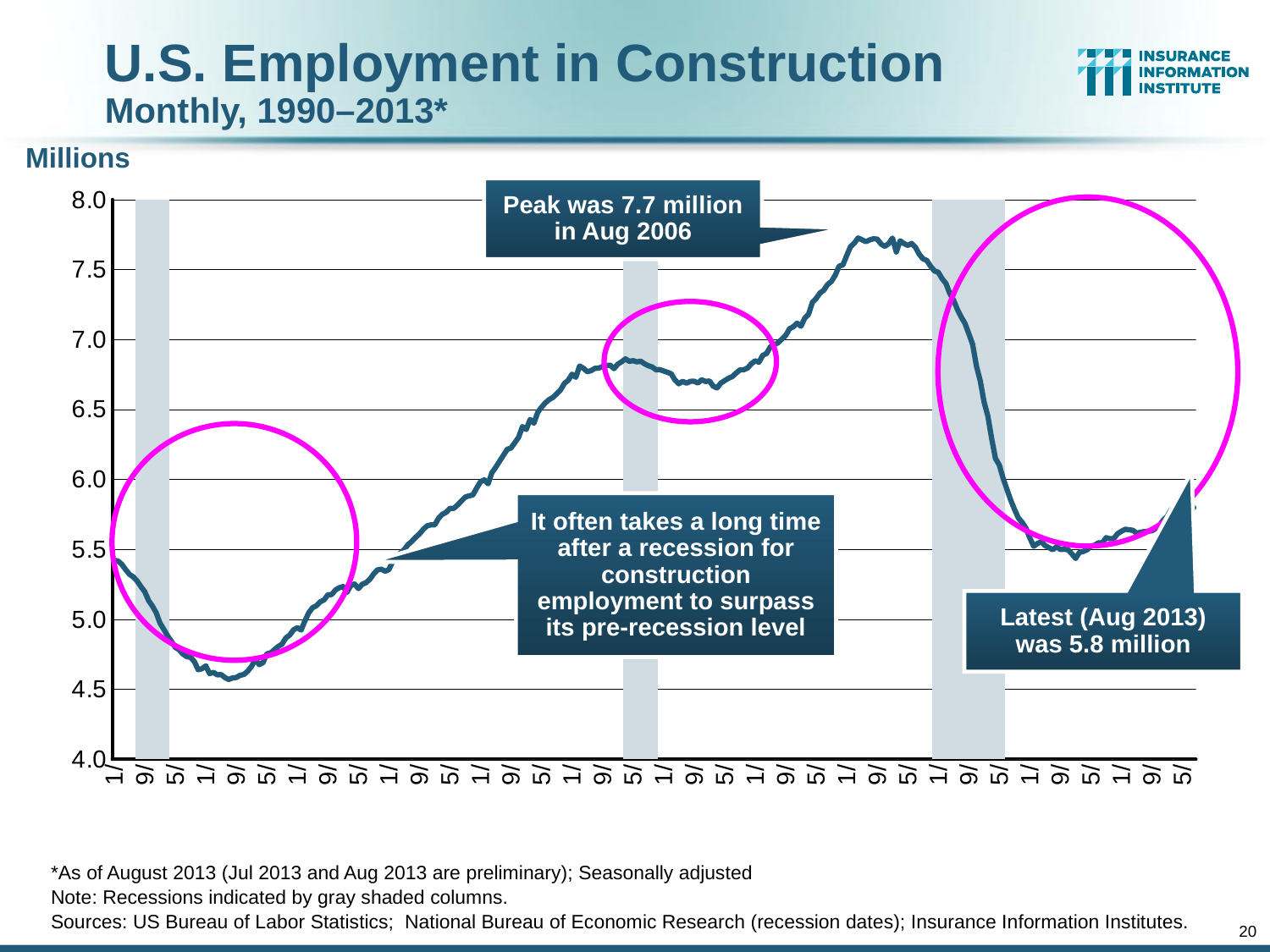
Is the value of the line during the 2001 recession (middle gray column) greater or less than 6.5 million? greater What unit is indicated for the y-axis of the chart? Millions Is the lowest point of the line in the early 1990s greater or less than 5.0 million? less Does construction employment rise or fall between the Aug 2006 peak and the end of the third gray recession column? fall In which month and year did U.S. construction employment reach its peak? Aug 2006 According to the note on the slide, what do the gray shaded columns indicate? Recessions What was the latest (Aug 2013) value of U.S. construction employment? 5.8 million What kind of chart is shown on the slide? line chart Which is larger: construction employment at the Aug 2006 peak or in Aug 2013? Aug 2006 peak How much lower was construction employment in Aug 2013 than at its Aug 2006 peak? 1.9 million What was the peak value of U.S. construction employment according to the chart annotation? 7.7 million How many gray shaded recession columns are shown on the chart? 3